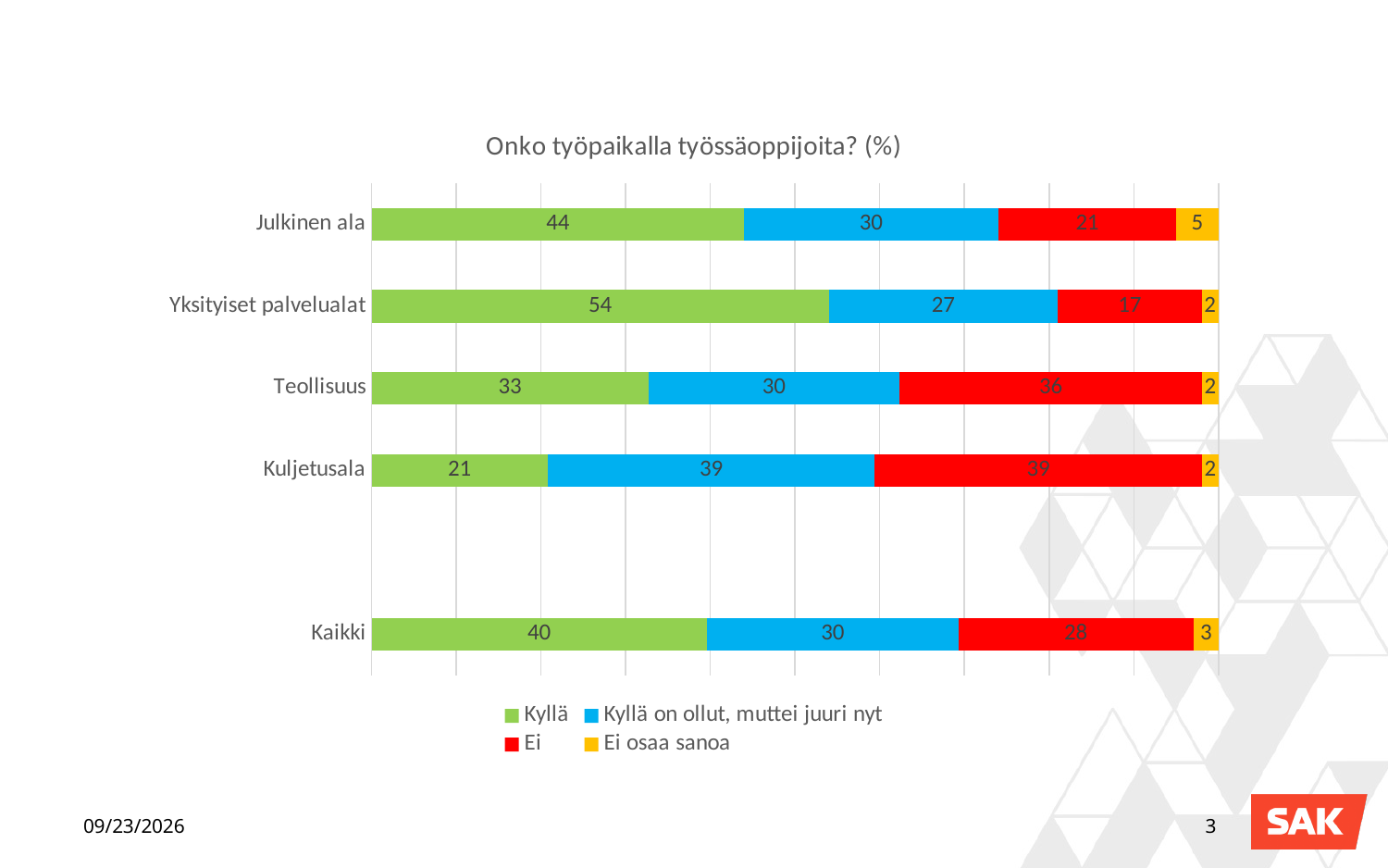
What is the value of "Kyllä" for Yksityiset palvelualat? 54 Which category has the highest "Kyllä" value? Yksityiset palvelualat Which category has the lowest "Kyllä" value? Kuljetusala What is the value of "Ei" for Teollisuus? 36 How many categories are shown on the chart? 5 Which is larger: the "Ei" value for Kaikki or the "Ei" value for Yksityiset palvelualat? Kaikki How many series does the legend list? 4 What is the value of "Ei osaa sanoa" for Julkinen ala? 5 What is the difference between the "Kyllä" values for Julkinen ala and Teollisuus? 11 What kind of chart is shown on the slide? Stacked bar chart What is the value of "Kyllä on ollut, muttei juuri nyt" for Kuljetusala? 39 What is the total of the stacked bar for Julkinen ala? 100